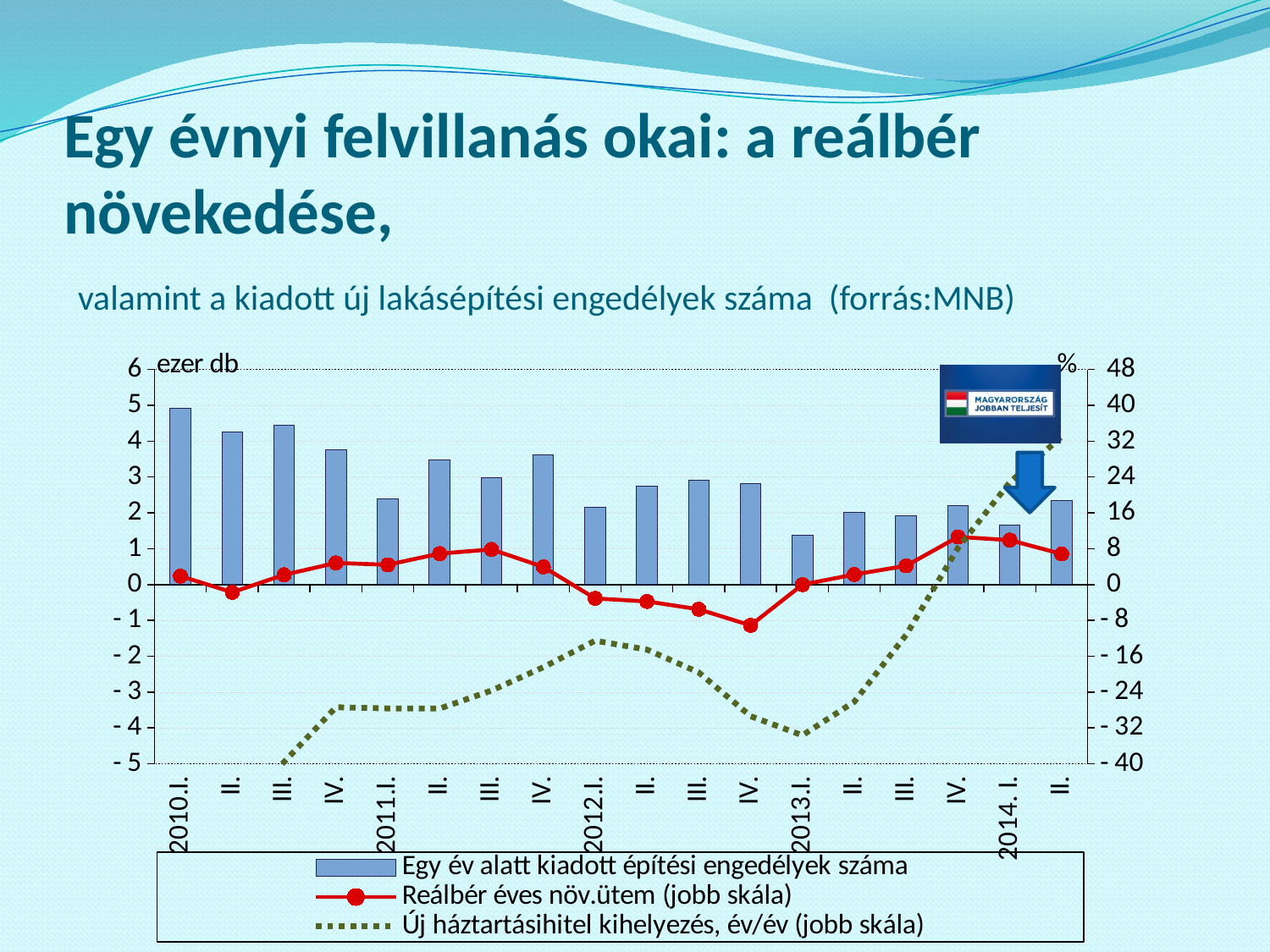
Is the dotted line value (Új háztartásihitel kihelyezés) for 2014. I. greater or less than 16%? greater In which quarter is the bar for building permits issued (Egy év alatt kiadott építési engedélyek száma) the highest? 2010.I. What kind of chart is shown on the slide? A combined bar and line chart How many quarterly categories are shown on the x axis? 18 In which quarter does the red line (Reálbér éves növ.ütem) reach its lowest point? 2012.IV. Which bar is taller, 2011.II. or 2011.III.? 2011.II. Is the red line value (Reálbér éves növ.ütem) for 2012.IV. greater or less than 0%? less Is the bar value for 2013.I. greater or less than 2 (ezer db)? less In which quarter is the bar for building permits issued the lowest? 2013.I. How many series does the legend list? 3 What unit is shown at the top of the left axis? ezer db